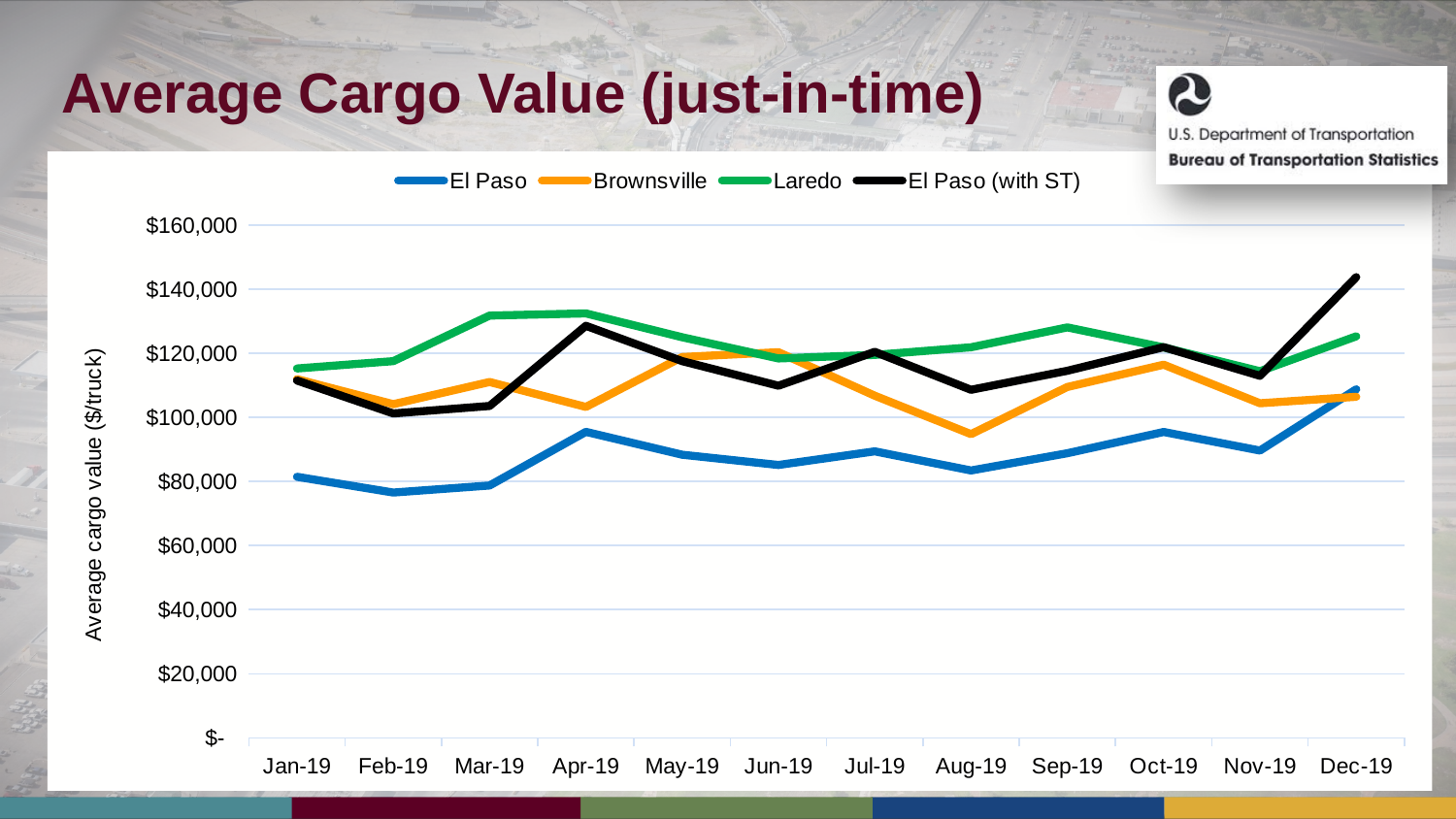
Does the Laredo series rise or fall from Jan-19 to Apr-19? rise Is the value for El Paso (with ST) in Dec-19 greater or less than $140,000? greater How many months are plotted along the x axis? 12 Which series has the lowest value in Jan-19? El Paso In which month does the El Paso (with ST) series reach its highest value? Dec-19 Is the value for Brownsville in Aug-19 greater or less than $100,000? less Is the value for El Paso in Feb-19 greater or less than $80,000? less How many series does the legend list? 4 What kind of chart is shown on the slide? line chart In Apr-19, which is larger: Brownsville or El Paso (with ST)? El Paso (with ST) What is the label on the y axis? Average cargo value ($/truck) Which series has the highest value in Dec-19? El Paso (with ST)